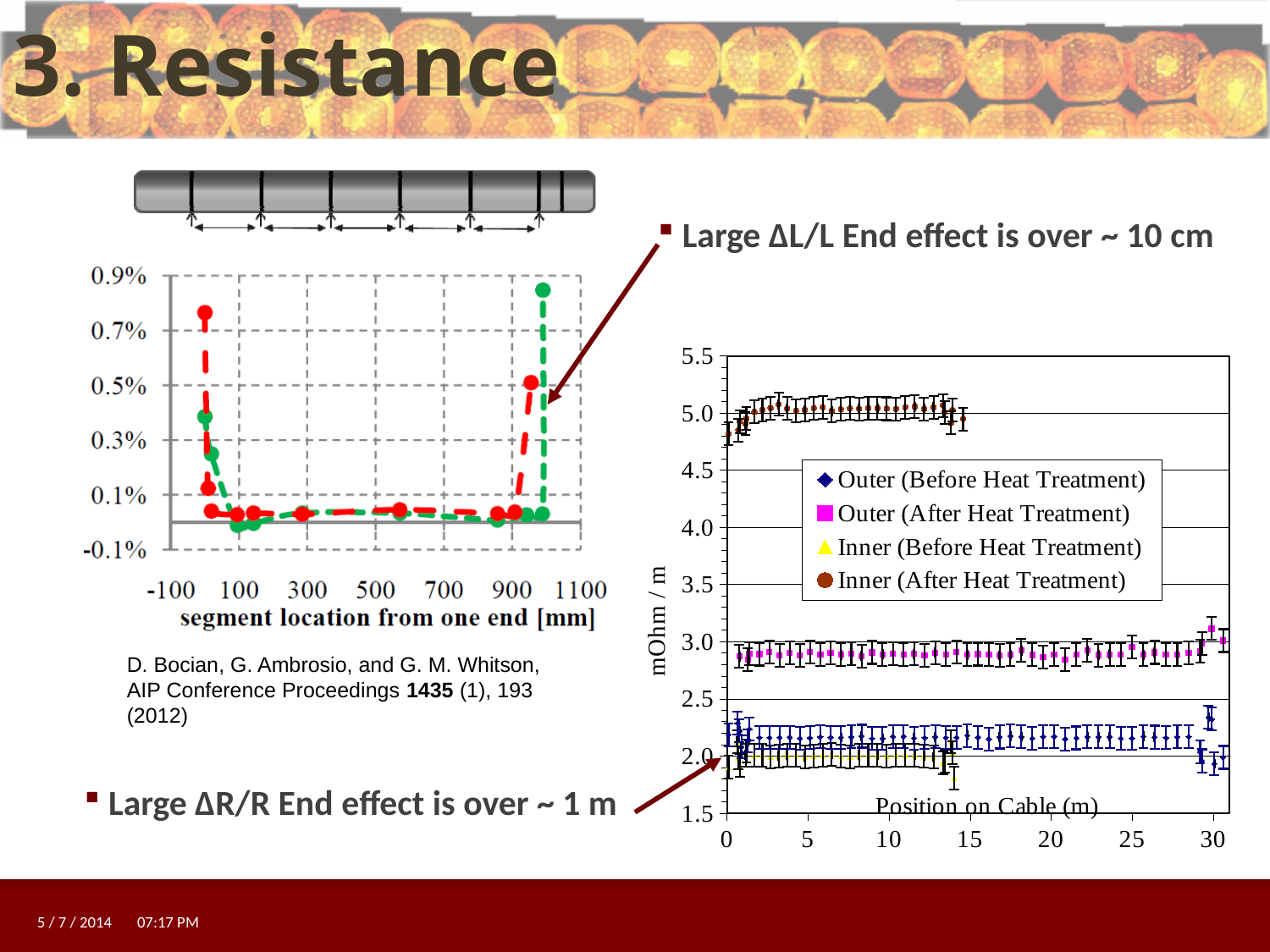
On the right chart, are the values for Outer (After Heat Treatment) greater or less than 2.5? greater On the left chart, what is the label of the x axis? segment location from one end [mm] On the right chart, what is the label of the y axis? mOhm / m On the right chart, are the values for Inner (After Heat Treatment) greater or less than 4.5? greater On the right chart, how many series does the legend list? 4 On the right chart, which series has larger values, Outer (After Heat Treatment) or Inner (After Heat Treatment)? Inner (After Heat Treatment) On the right chart, which series has the highest values? Inner (After Heat Treatment) On the right chart, are the values for Outer (After Heat Treatment) greater or less than 3.5? less On the right chart, what is the label of the x axis? Position on Cable (m) On the left chart, how do the values change from the ends of the cable toward the middle? They fall sharply near the ends and stay near 0% in the middle